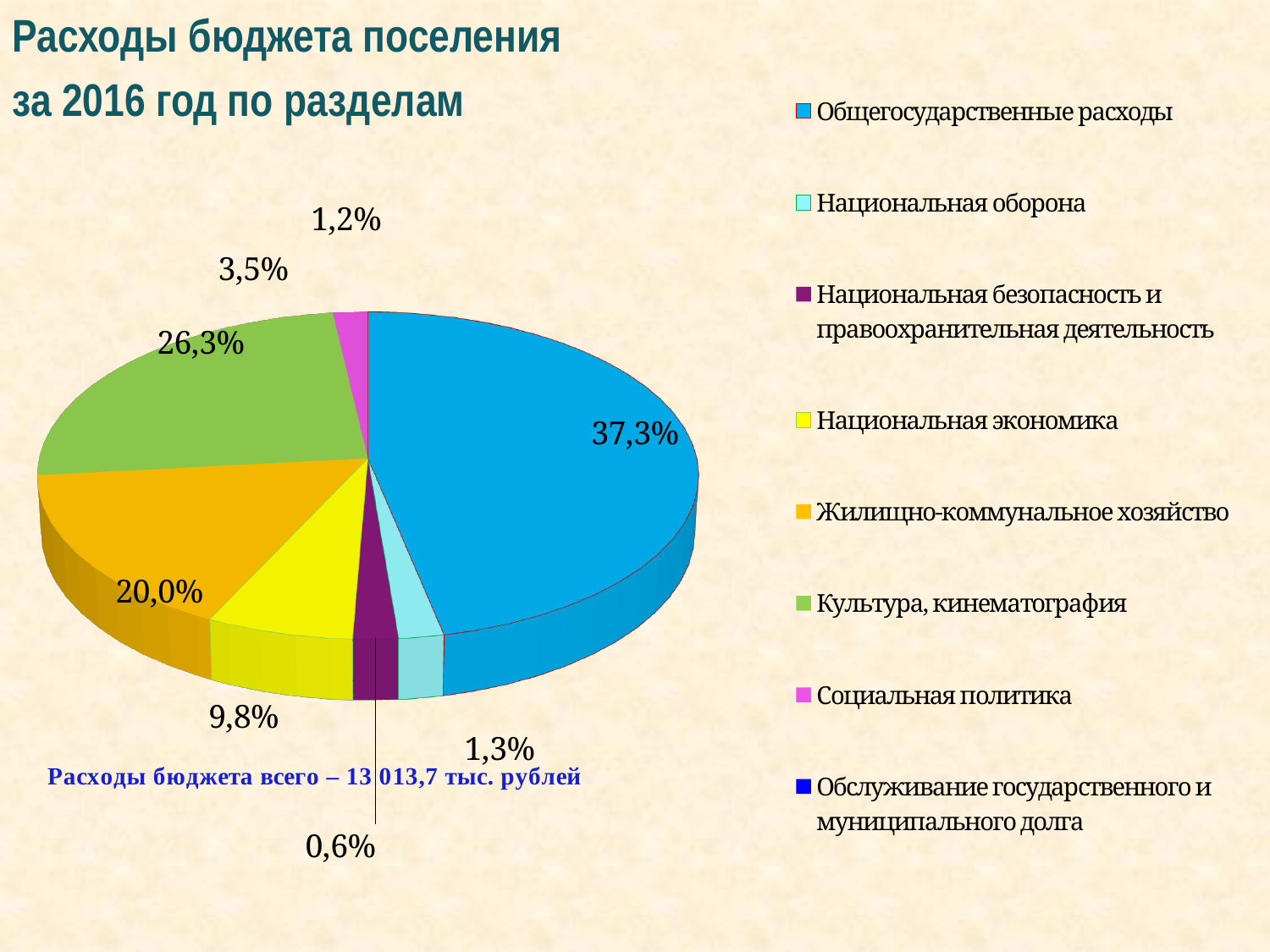
Which is larger: the share of Жилищно-коммунальное хозяйство or the share of Национальная экономика? Жилищно-коммунальное хозяйство What share of the pie does Национальная экономика have? 9,8% What share of the pie does Жилищно-коммунальное хозяйство have? 20,0% How many categories does the legend list? 8 What share of the pie does Национальная оборона have? 1,3% Which category has the largest share of the pie? Общегосударственные расходы What is the difference between the shares of Общегосударственные расходы and Культура, кинематография? 11,0% What type of chart is shown on the slide? pie chart Which category has the smallest share of the pie? Национальная безопасность и правоохранительная деятельность